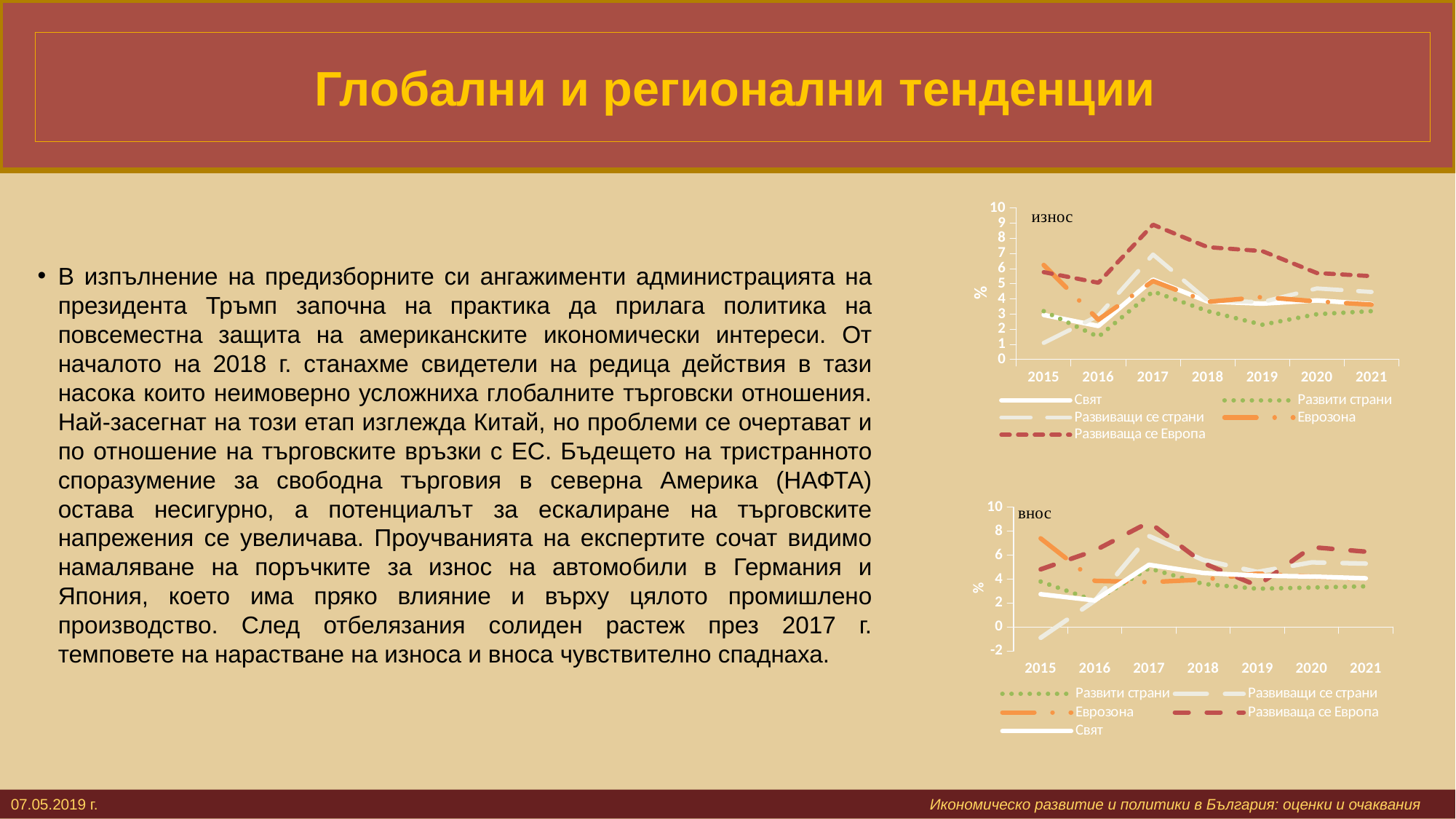
In the "износ" chart, is the value for Развиващи се страни in 2015 greater or less than 2? less What kind of chart is the "износ" chart? line chart How many series does the legend of the "внос" chart list? 5 In the "износ" chart, is the value for Развиваща се Европа in 2017 greater or less than 8? greater In the "внос" chart, which series has the lowest value in 2015? Развиващи се страни In the "износ" chart, does the Развиваща се Европа series rise or fall from 2017 to 2021? fall In the "внос" chart, is the value for Развиващи се страни in 2015 greater or less than 0? less In the "внос" chart, which is larger in 2015: Еврозона or Развиваща се Европа? Еврозона How many years are shown on the x axis of the "износ" chart? 7 In the "износ" chart, which series has the highest value in 2017? Развиваща се Европа What is the y-axis label of the "износ" chart? %